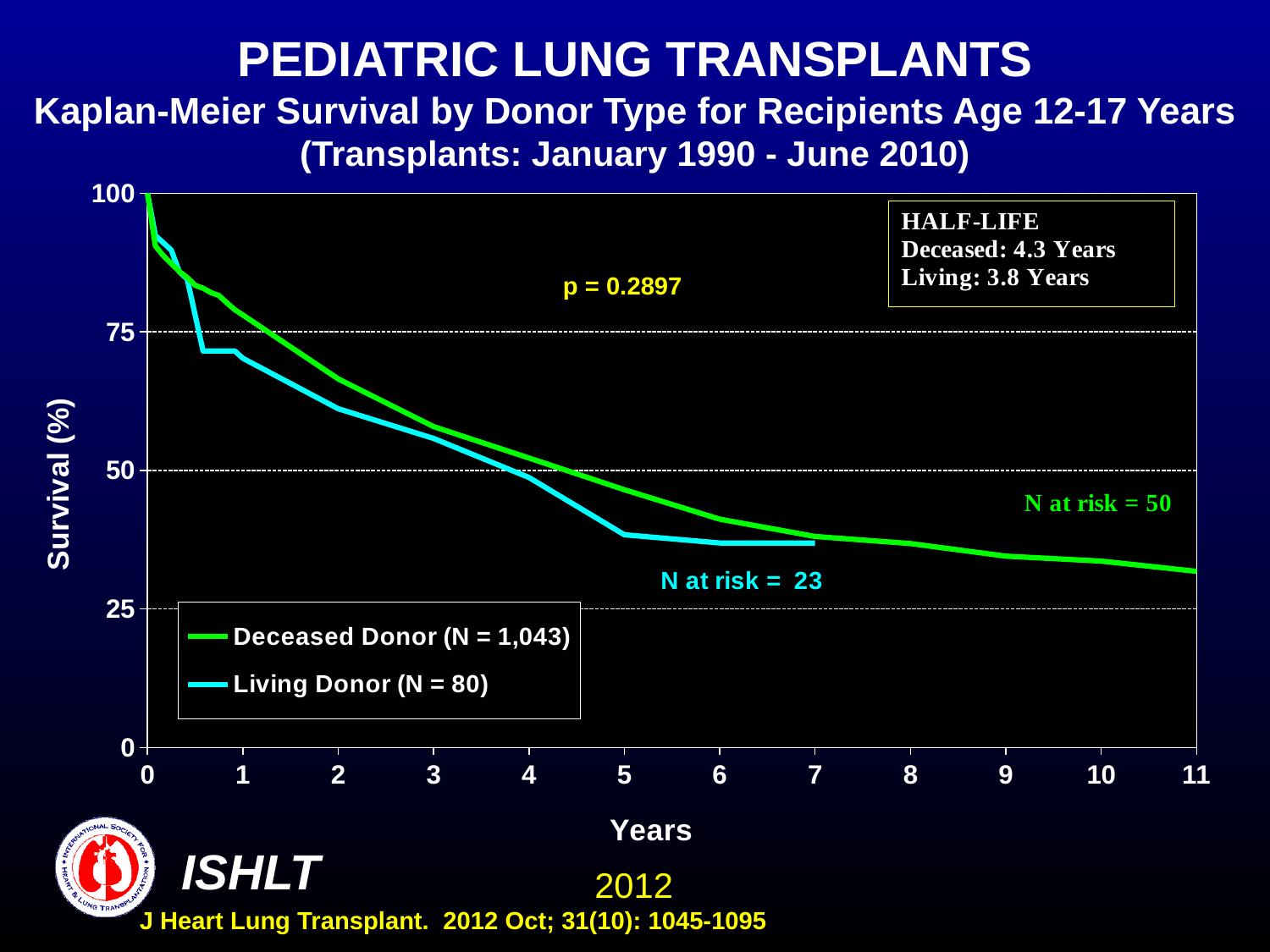
What is the p-value printed on the chart? p = 0.2897 What is the N for the Living Donor series in the legend? 80 Do the survival curves rise or fall as years increase? Fall What kind of chart is shown on the slide? Line chart How many series does the legend list? 2 What is the half-life for living donor recipients shown in the box? 3.8 Years Is the survival value for the Deceased Donor curve at 5 years greater or less than 50? less What is the N for the Deceased Donor series in the legend? 1,043 What is the half-life for deceased donor recipients shown in the box? 4.3 Years At 1 year, which curve shows higher survival, Deceased Donor or Living Donor? Deceased Donor Is the survival value for the Living Donor curve at 1 year greater or less than 75? less What is the N at risk printed for the Living Donor curve? 23